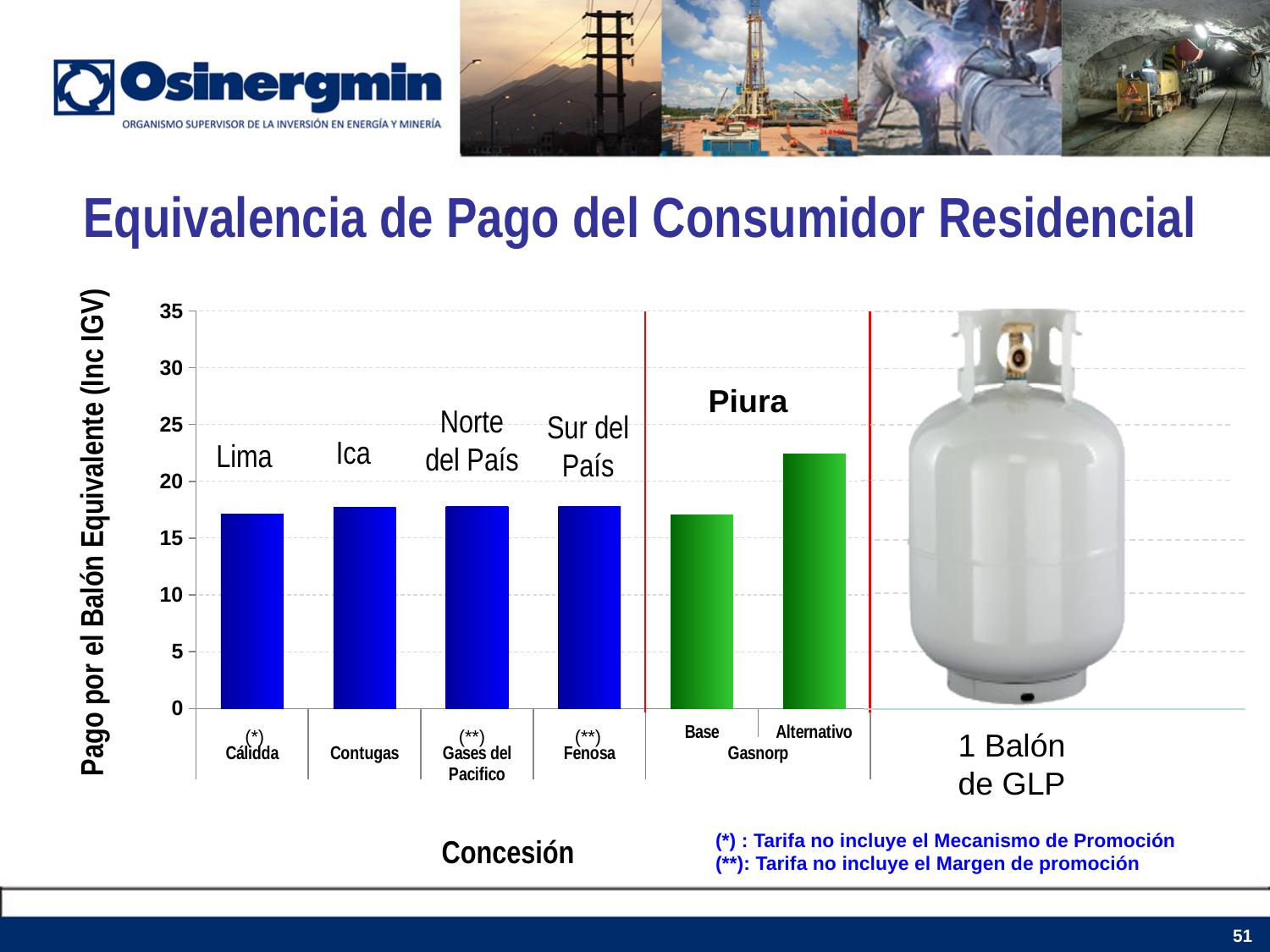
Is the value for the Gasnorp Alternativo bar greater or less than 20? greater Is the value for the Gasnorp Base bar greater or less than 20? less What colour are the two Gasnorp (Piura) bars? green What is the title of the chart on the slide? Equivalencia de Pago del Consumidor Residencial Is the value for Contugas greater or less than 15? greater Which bar in the chart is the highest? Alternativo (Gasnorp) How many bars are plotted in the chart? 6 What kind of chart is shown on the slide? bar chart Which is larger, the Gasnorp Base bar or the Gasnorp Alternativo bar? Alternativo